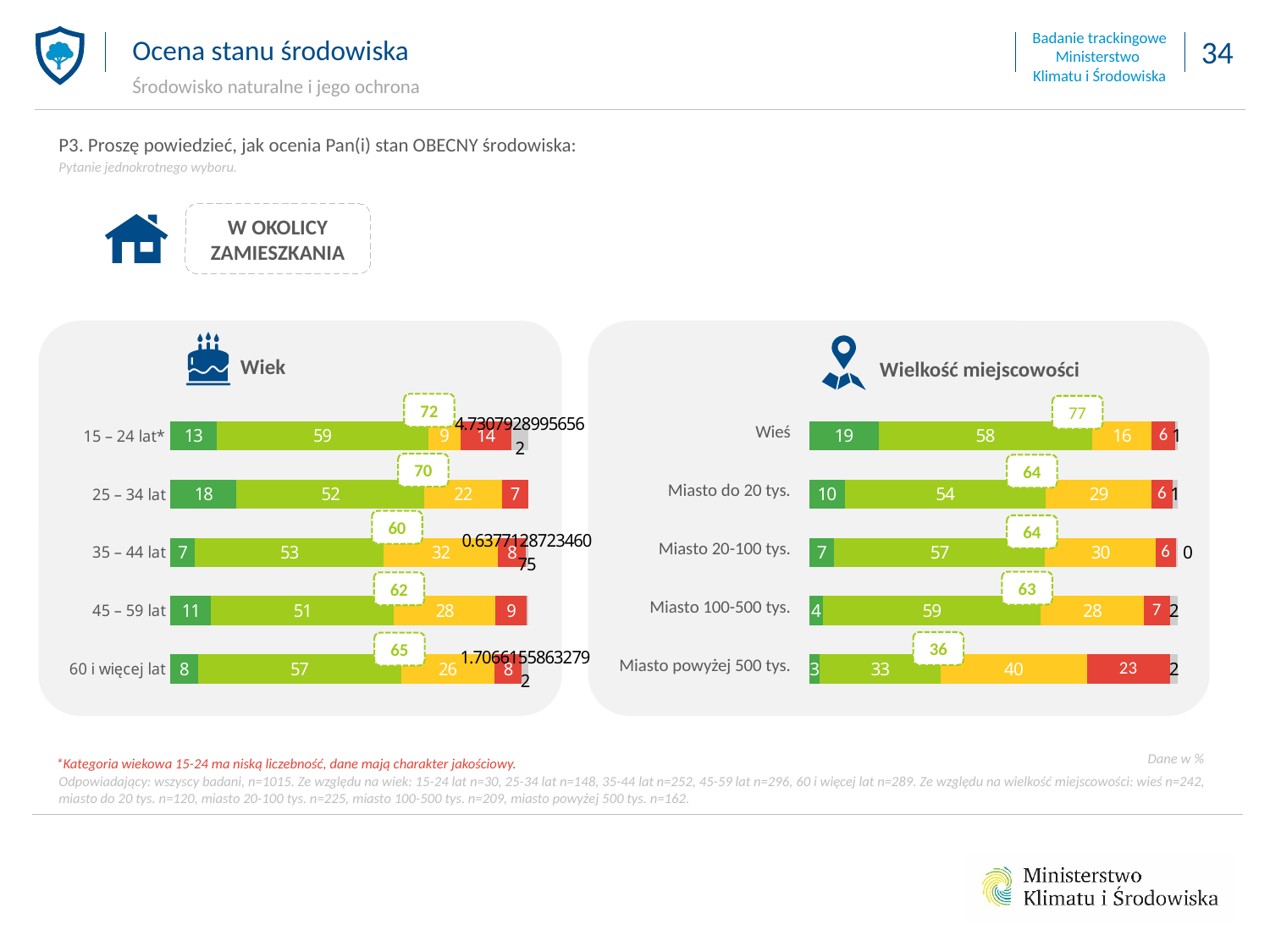
In the "Wiek" chart, what is the value of the yellow segment for 35 – 44 lat? 32 In the "Wielkość miejscowości" chart, what is the difference between the callout values for Wieś and Miasto powyżej 500 tys.? 41 In the "Wiek" chart, what is the callout value shown above the bar for 25 – 34 lat? 70 In the "Wielkość miejscowości" chart, which category has the lowest callout value? Miasto powyżej 500 tys. In the "Wiek" chart, which age group has the highest callout value? 15 – 24 lat* What kind of chart is the "Wiek" chart? stacked bar chart In the "Wielkość miejscowości" chart, what is the callout value for Wieś? 77 In the "Wielkość miejscowości" chart, what is the value of the red segment for Miasto powyżej 500 tys.? 23 In the "Wiek" chart, which age group has the lowest callout value? 35 – 44 lat In the "Wielkość miejscowości" chart, what is the total of all segments in the Wieś bar? 100 In the "Wiek" chart, which has the larger light green segment: 25 – 34 lat or 60 i więcej lat? 60 i więcej lat How many age categories are shown in the "Wiek" chart? 5